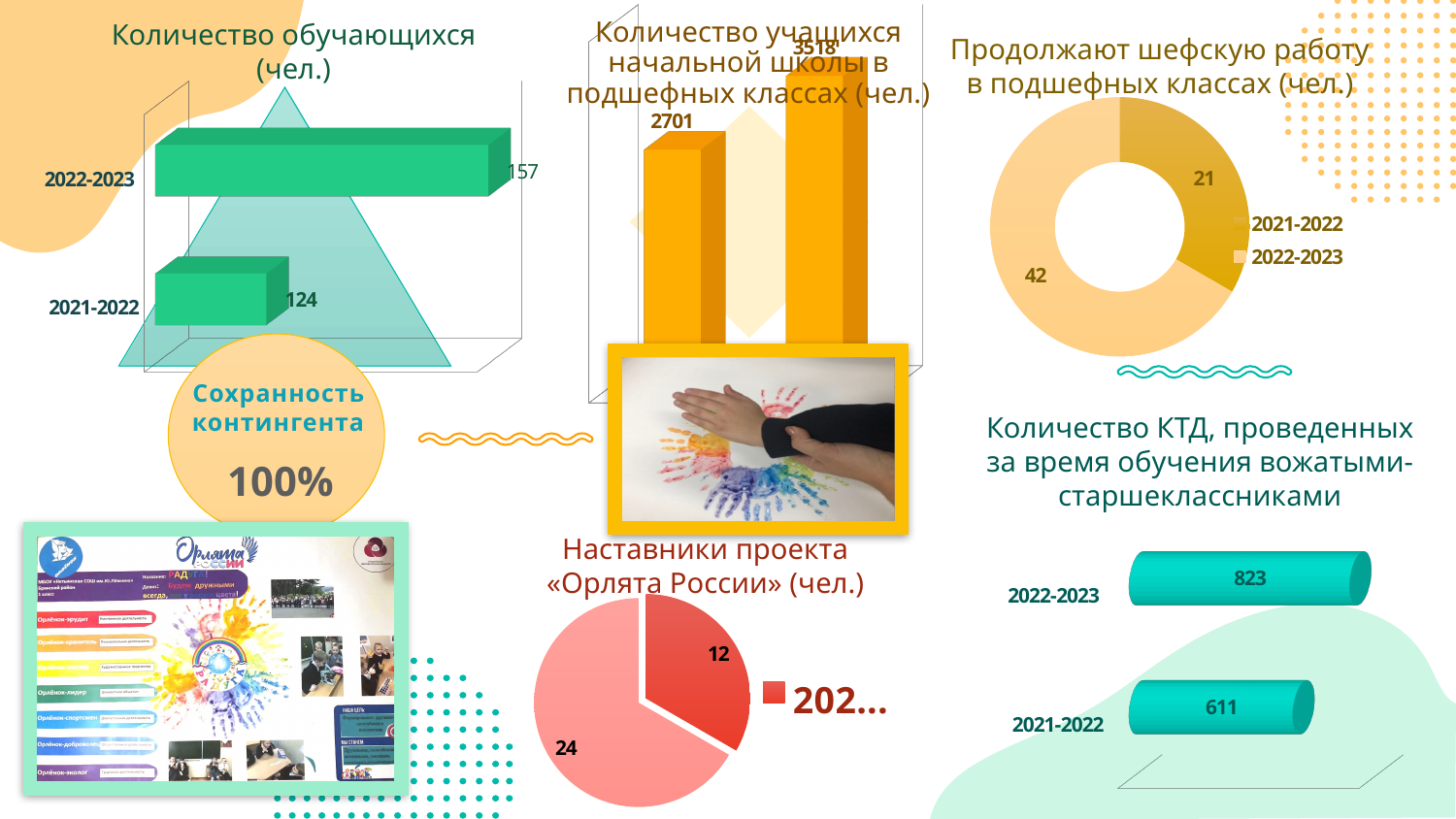
In the chart 'Продолжают шефскую работу в подшефных классах (чел.)', what is the total of the two values shown? 63 What kind of chart is 'Продолжают шефскую работу в подшефных классах (чел.)'? Doughnut chart In the chart 'Количество обучающихся (чел.)', what is the difference between the 2022-2023 and 2021-2022 values? 33 In the pie chart 'Наставники проекта «Орлята России» (чел.)', what is the value of the larger slice? 24 In the chart 'Количество КТД, проведенных за время обучения вожатыми-старшеклассниками', which year has the larger value, 2022-2023 or 2021-2022? 2022-2023 In the chart 'Количество учащихся начальной школы в подшефных классах (чел.)', what is the value of the shorter bar? 2701 What kind of chart is 'Количество обучающихся (чел.)'? Bar chart In the chart 'Количество учащихся начальной школы в подшефных классах (чел.)', what is the value of the taller bar? 3518 In the chart 'Количество обучающихся (чел.)', what is the value for 2022-2023? 157 In the chart 'Количество КТД, проведенных за время обучения вожатыми-старшеклассниками', what is the value for 2022-2023? 823 In the chart 'Количество обучающихся (чел.)', what is the value for 2021-2022? 124 In the chart 'Продолжают шефскую работу в подшефных классах (чел.)', how many series does the legend list? 2